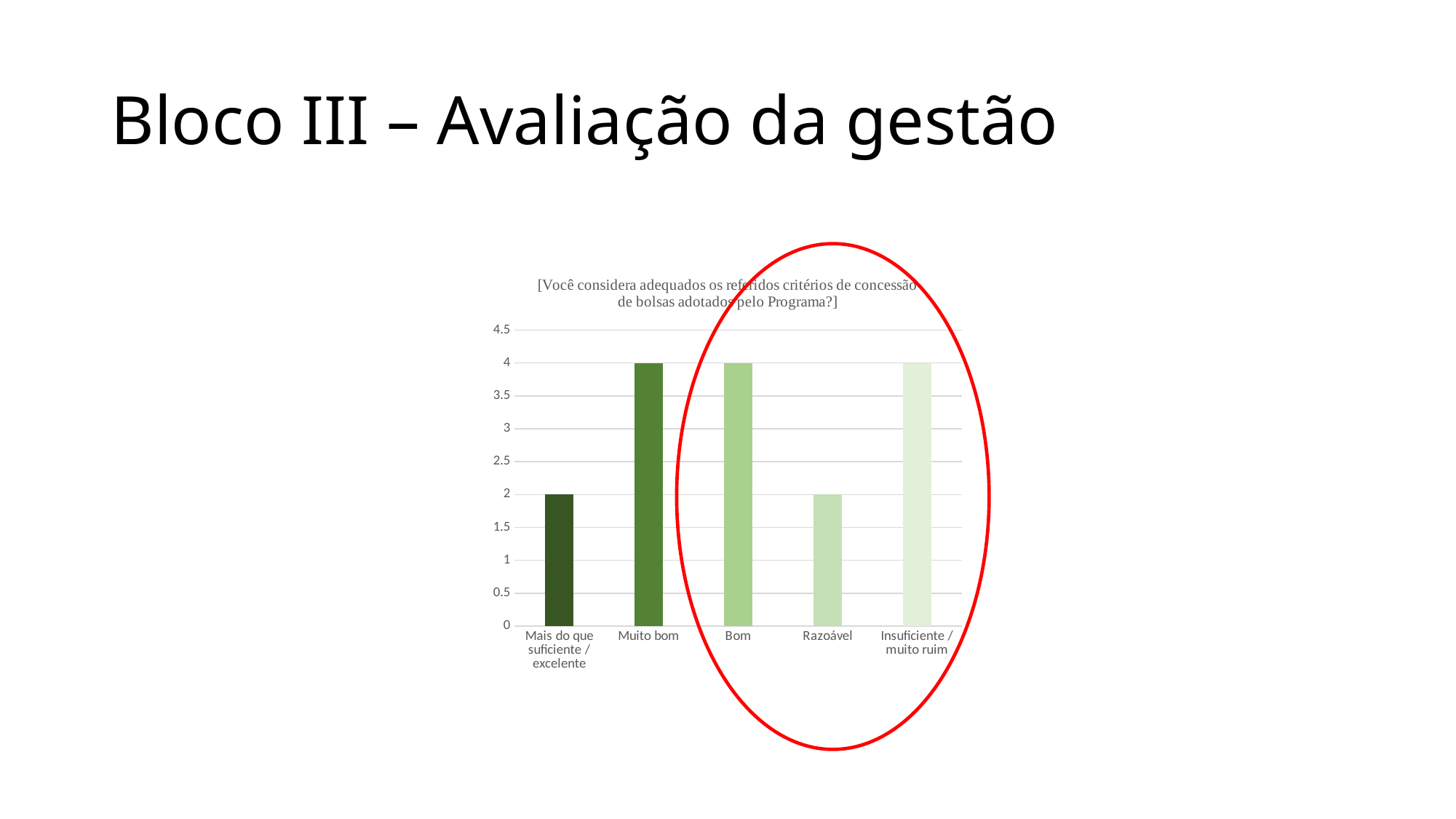
How many categories are shown on the x axis? 5 What is the value for Insuficiente / muito ruim? 4 What is the value for Bom? 4 What is the value for Mais do que suficiente / excelente? 2 Is the value for Razoável greater or less than 3? less What is the value for Muito bom? 4 What is the value for Razoável? 2 Is the value for Insuficiente / muito ruim greater or less than 3? greater Which is larger, the value for Muito bom or the value for Razoável? Muito bom Which categories are enclosed by the red ellipse drawn over the chart? Bom, Razoável, Insuficiente / muito ruim What kind of chart is shown on the slide? bar chart What is the difference between the value for Bom and the value for Razoável? 2